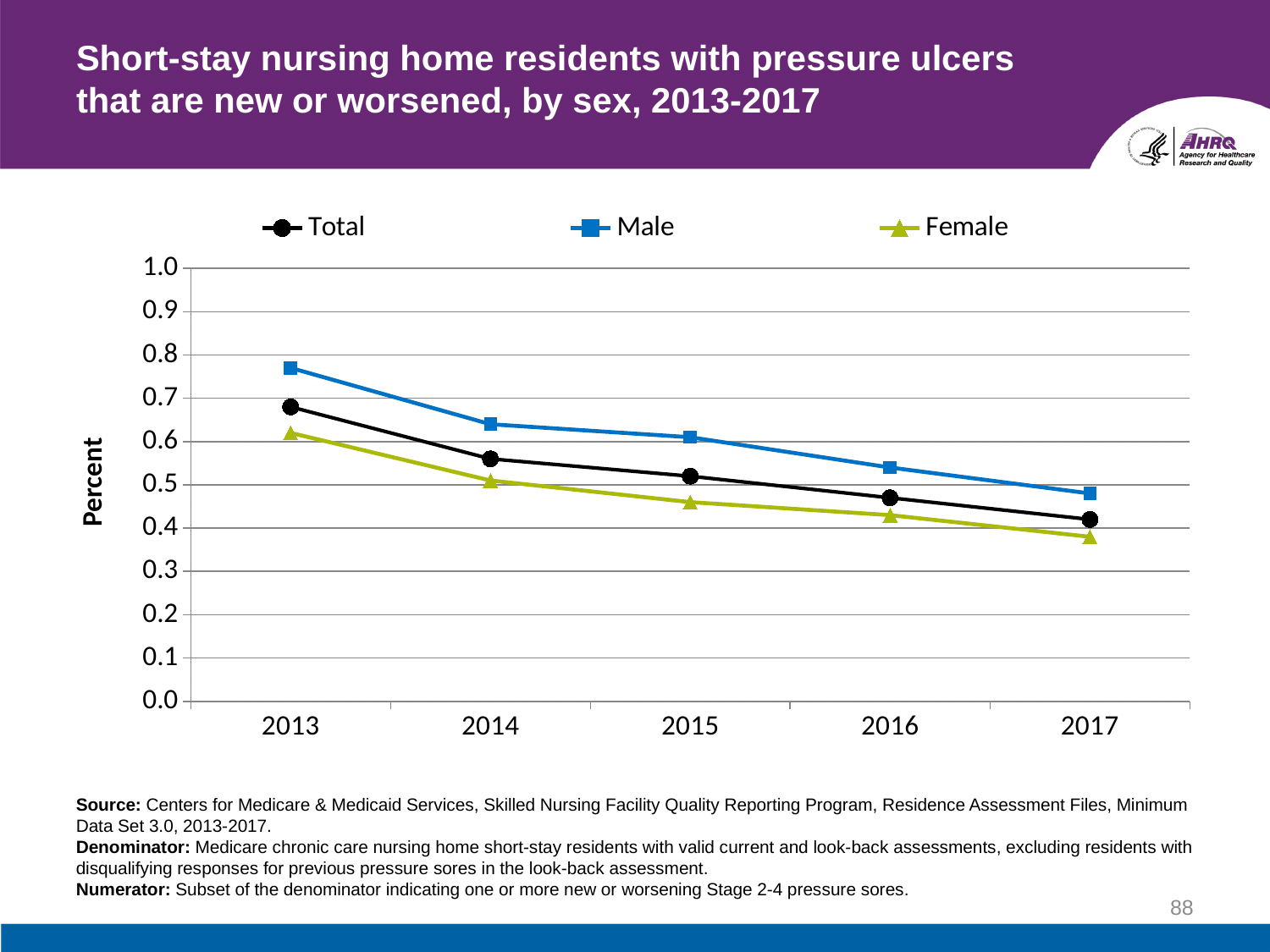
Is the value for Female in 2017 greater or less than 0.4? less In 2013, which is larger, the value for Male or the value for Female? Male What is the label on the y axis? Percent How many series does the legend list? 3 Is the value for Male in 2016 greater or less than 0.5? greater Do the values for the Male series rise or fall from 2013 to 2017? fall Is the value for Total in 2016 greater or less than 0.5? less In which year is the Male series at its highest? 2013 How many years are plotted along the x axis? 5 What kind of chart is shown on the slide? line chart